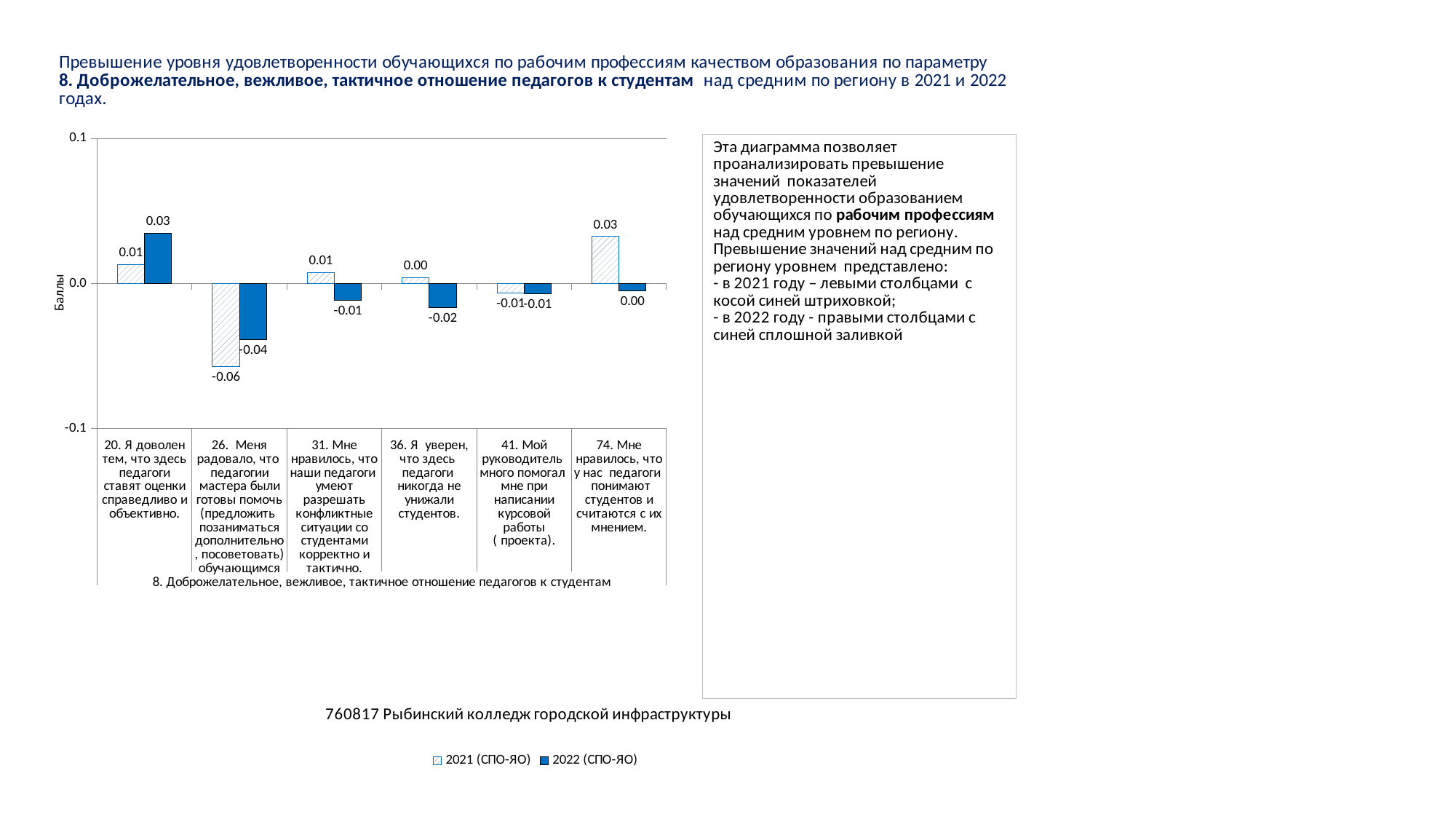
Which category has the lowest 2021 (СПО-ЯО) value? 26. Меня радовало, что педагоги и мастера были готовы помочь What is the 2021 (СПО-ЯО) value for category 74 (Мне нравилось, что у нас педагоги понимают студентов и считаются с их мнением)? 0.03 What is the label of the vertical axis of the chart? Баллы How many series does the chart legend list? 2 What is the 2022 (СПО-ЯО) value for category 20 (Я доволен тем, что здесь педагоги ставят оценки справедливо и объективно)? 0.03 What is the 2021 (СПО-ЯО) value for category 26 (Меня радовало, что педагоги и мастера были готовы помочь)? -0.06 For category 31, which is larger: the 2021 (СПО-ЯО) value or the 2022 (СПО-ЯО) value? 2021 (СПО-ЯО) How many categories (questions) are shown on the x axis of the chart? 6 Which category has the highest 2022 (СПО-ЯО) value? 20. Я доволен тем, что здесь педагоги ставят оценки справедливо и объективно What type of chart is shown on the slide? Bar chart What is the difference between the 2022 and 2021 values for category 26? 0.02 What is the 2022 (СПО-ЯО) value for category 36 (Я уверен, что здесь педагоги никогда не унижали студентов)? -0.02